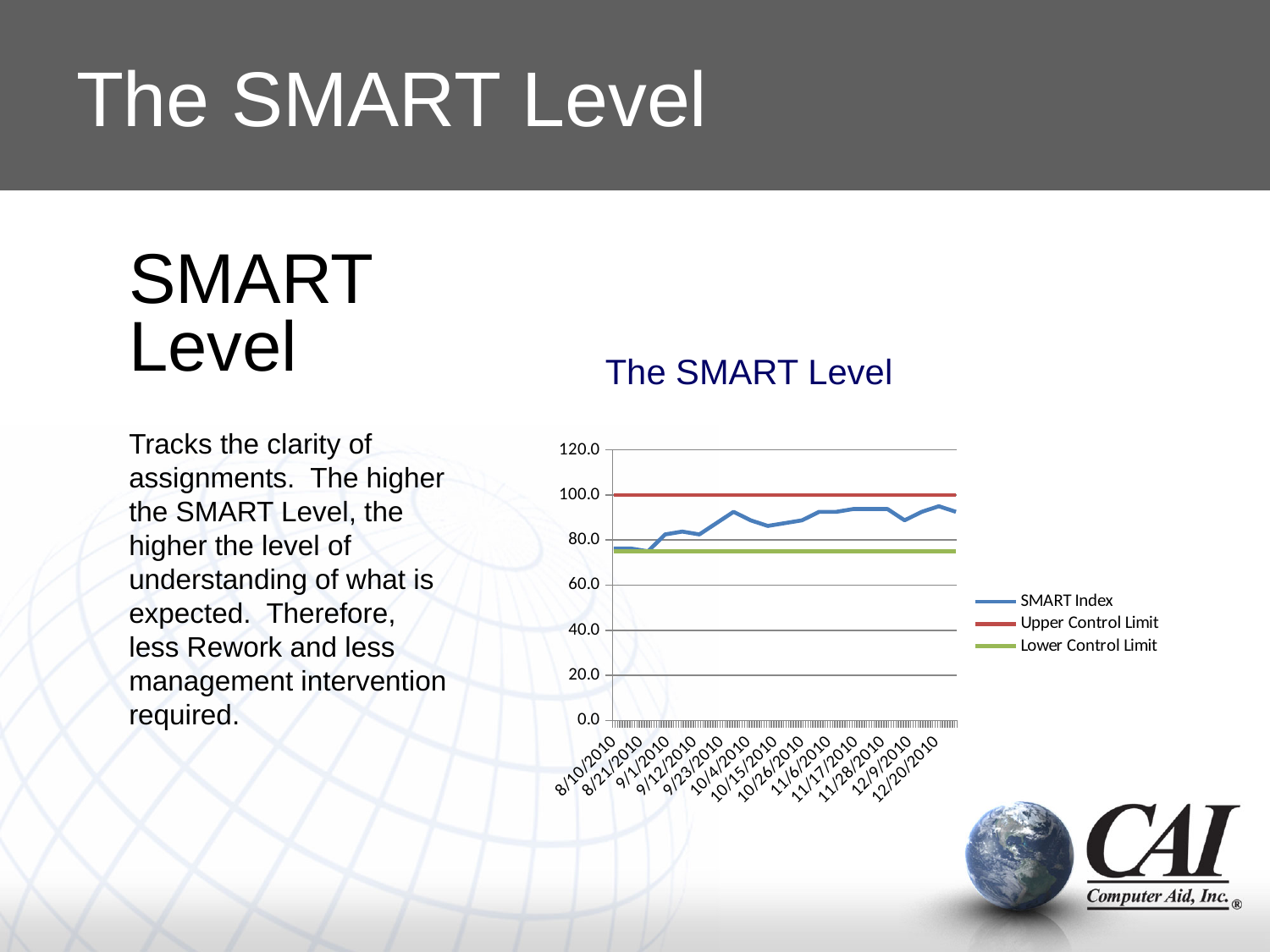
What kind of chart is shown on the slide? line chart What value does the Upper Control Limit line sit at? 100.0 Is the Lower Control Limit line greater or less than 60.0? greater Is the SMART Index value at 12/20/2010 greater or less than 80.0? greater Is the Lower Control Limit line greater or less than 80.0? less What is the title of the chart? The SMART Level Does the SMART Index generally rise or fall from 8/10/2010 to 12/20/2010? rise At 12/20/2010, which is larger, the SMART Index or the Upper Control Limit? Upper Control Limit Which is larger, the Upper Control Limit or the Lower Control Limit? Upper Control Limit How many date labels are shown along the x axis? 13 How many series does the chart's legend list? 3